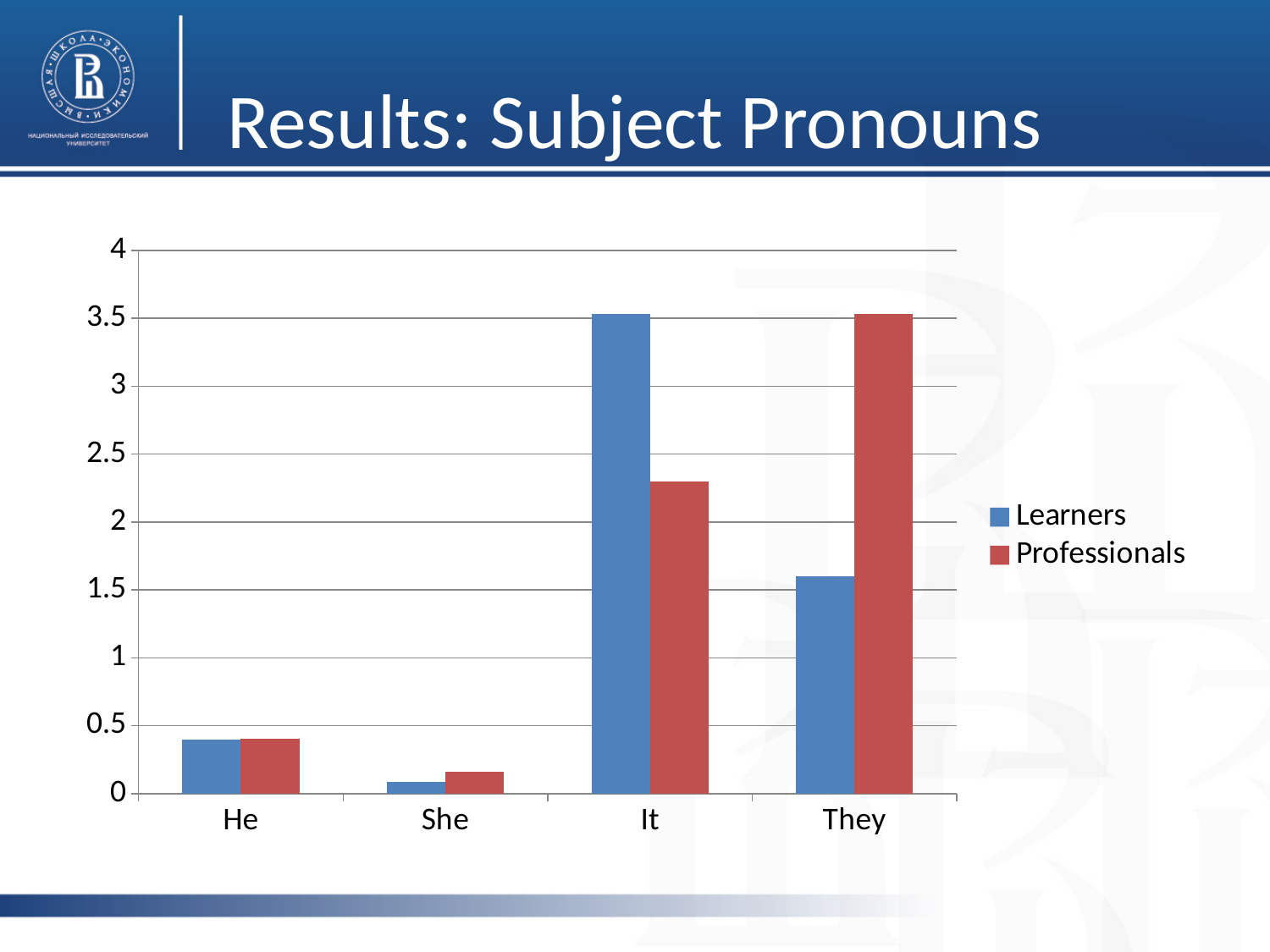
For the pronoun It, which series has the larger value, Learners or Professionals? Learners Is the value for Professionals for the pronoun It greater or less than 2.5? less What is the title of the slide containing the chart? Results: Subject Pronouns What kind of chart is shown on the slide? bar chart How many pronoun categories are shown on the x axis? 4 Which pronoun has the lowest value for Professionals? She Which pronoun has the lowest value for Learners? She For the pronoun They, which series has the larger value, Learners or Professionals? Professionals Which pronoun has the highest value for Learners? It How many series does the legend list? 2 Which pronoun has the highest value for Professionals? They Is the value for Learners for the pronoun They greater or less than 2? less